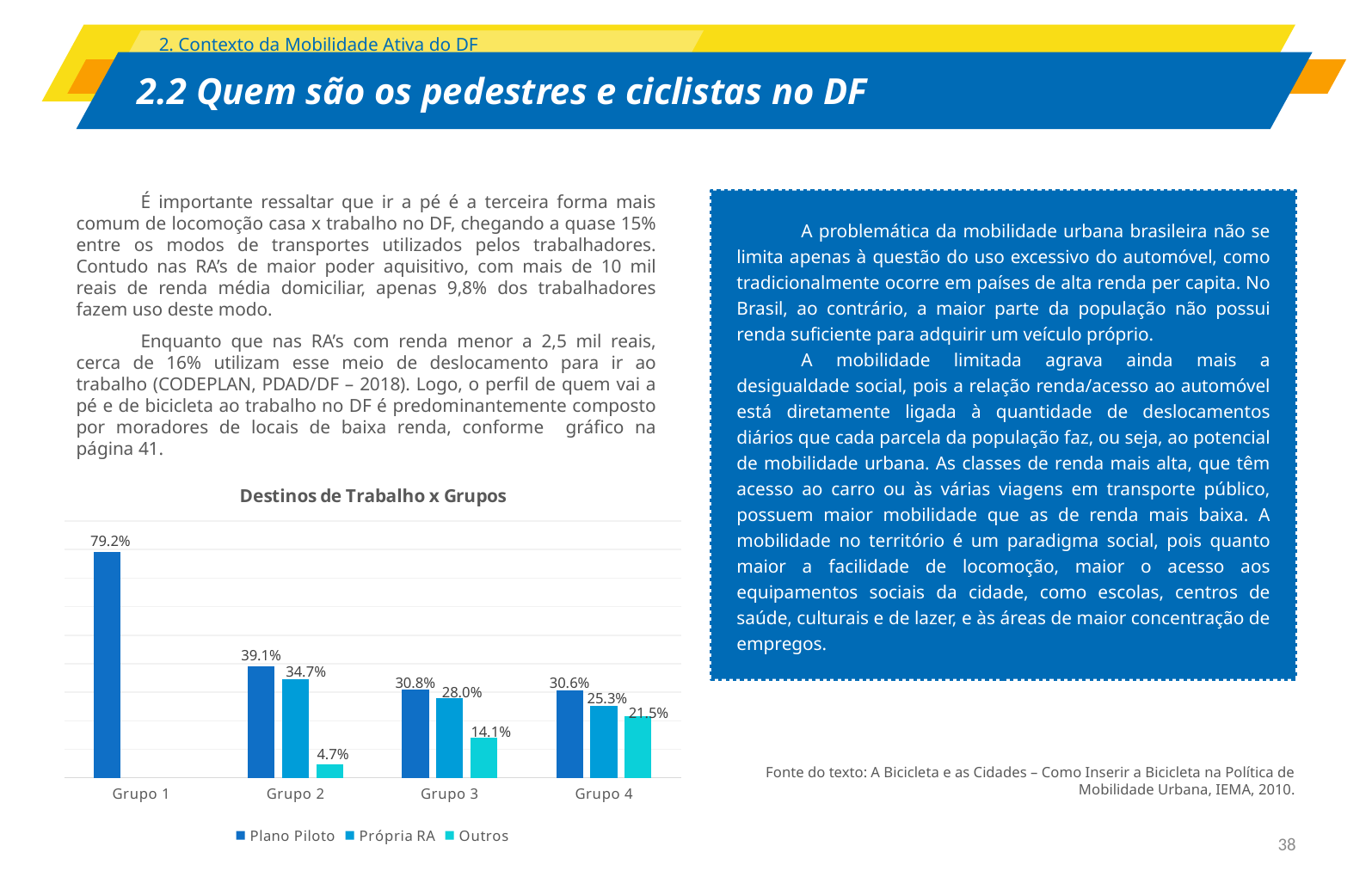
Which is larger for Grupo 4: the Própria RA value or the Outros value? Própria RA What is the Outros value for Grupo 2? 4.7% Which group has the lowest Outros value? Grupo 2 Which group has the highest Plano Piloto value? Grupo 1 What is the Plano Piloto value for Grupo 1? 79.2% What type of chart is shown on the slide? Bar chart How many groups are shown on the x axis of the chart? 4 What is the title of the chart? Destinos de Trabalho x Grupos How many series does the chart legend list? 3 What is the difference between the Plano Piloto and Própria RA values for Grupo 2? 4.4% What is the Outros value for Grupo 4? 21.5% What is the Própria RA value for Grupo 3? 28.0%